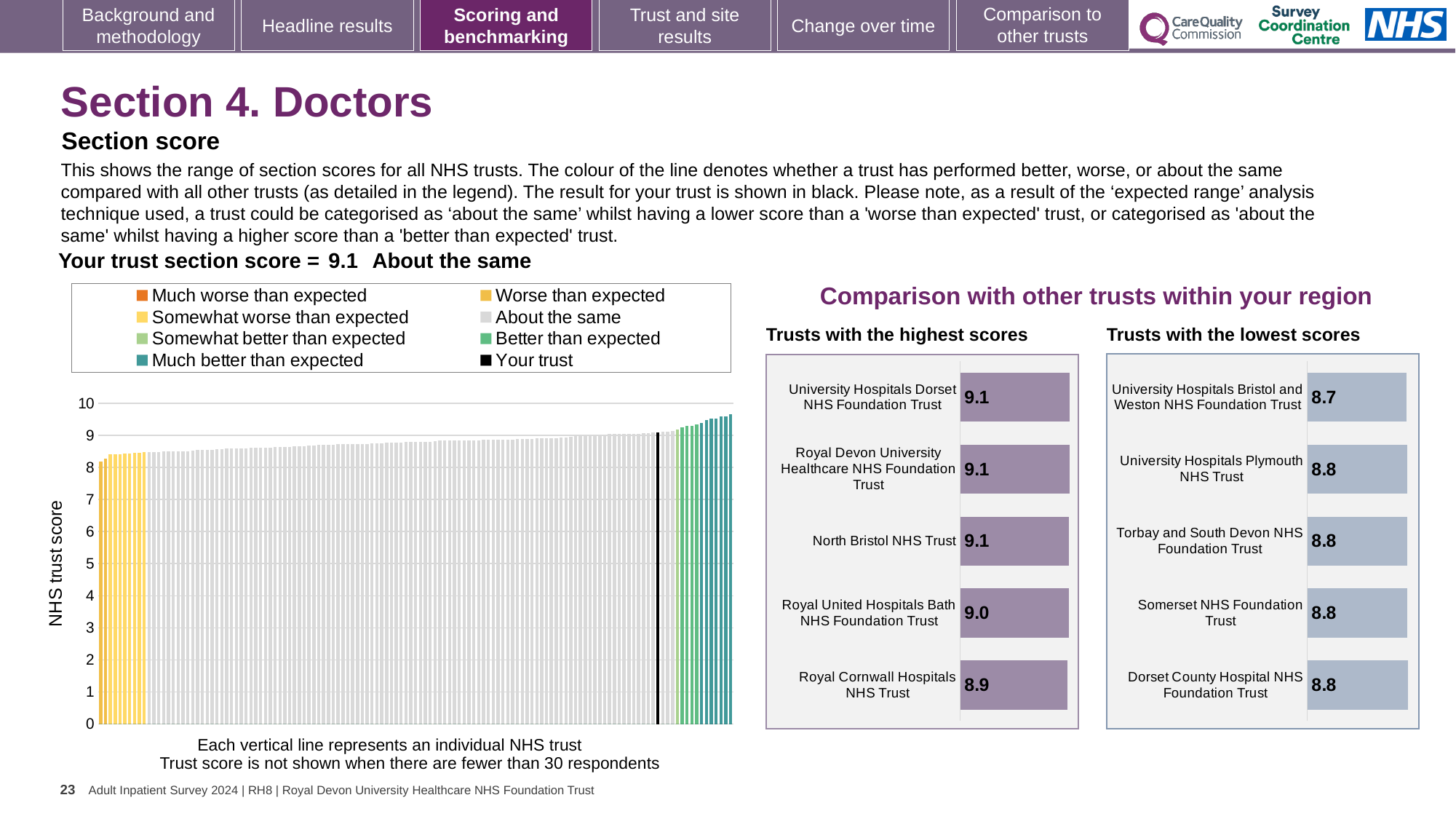
How many entries does the legend of the large chart on the left list? 8 How many trusts are listed in the 'Trusts with the lowest scores' chart? 5 In the 'Trusts with the highest scores' chart, what is the score for North Bristol NHS Trust? 9.1 In the 'Trusts with the highest scores' chart, what is the difference between the scores of University Hospitals Dorset NHS Foundation Trust and Royal Cornwall Hospitals NHS Trust? 0.2 In the 'Trusts with the highest scores' chart, which trust has the lowest score? Royal Cornwall Hospitals NHS Trust In the 'Trusts with the lowest scores' chart, what is the score for University Hospitals Bristol and Weston NHS Foundation Trust? 8.7 In the 'Trusts with the lowest scores' chart, what is the difference between the scores of Somerset NHS Foundation Trust and University Hospitals Bristol and Weston NHS Foundation Trust? 0.1 Which is larger: the score for Royal Cornwall Hospitals NHS Trust in the 'Trusts with the highest scores' chart or the score for Dorset County Hospital NHS Foundation Trust in the 'Trusts with the lowest scores' chart? Royal Cornwall Hospitals NHS Trust In the large chart on the left, is the value of the black bar representing your trust greater or less than 8? greater In the large chart on the left, do the trust scores rise or fall from left to right along the x axis? rise In the 'Trusts with the lowest scores' chart, which trust has the lowest score? University Hospitals Bristol and Weston NHS Foundation Trust In the 'Trusts with the highest scores' chart, what is the score for Royal Cornwall Hospitals NHS Trust? 8.9